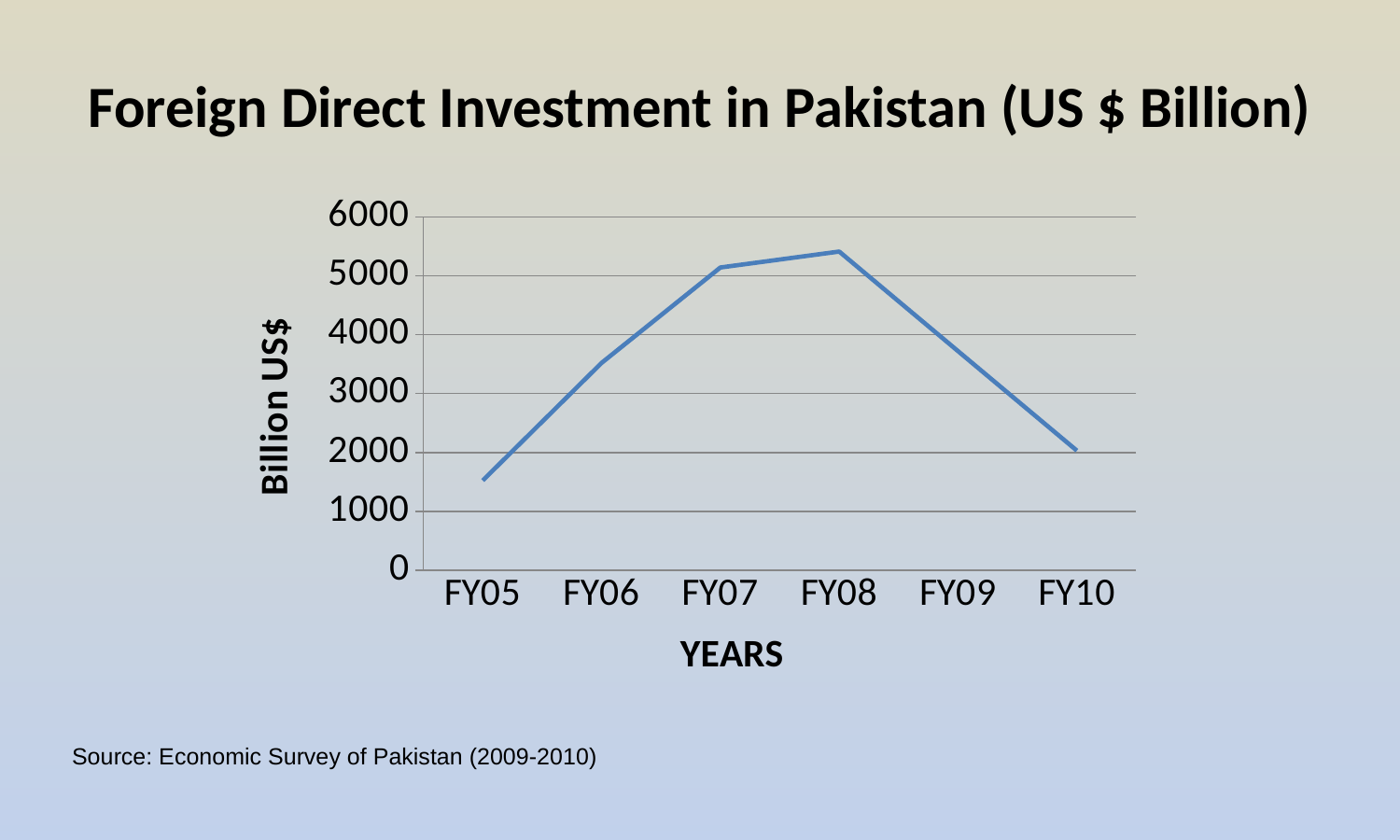
How many fiscal years are plotted on the x axis? 6 Is the value for FY10 greater or less than 3000? less Is the value for FY09 greater or less than 4000? less Is the value for FY05 greater or less than 2000? less Which fiscal year has the larger value, FY07 or FY10? FY07 What is the title of the vertical axis? Billion US$ In which fiscal year is foreign direct investment lowest? FY05 What kind of chart is shown on the slide? line chart How does foreign direct investment change from FY05 to FY08? it rises In which fiscal year is foreign direct investment highest? FY08